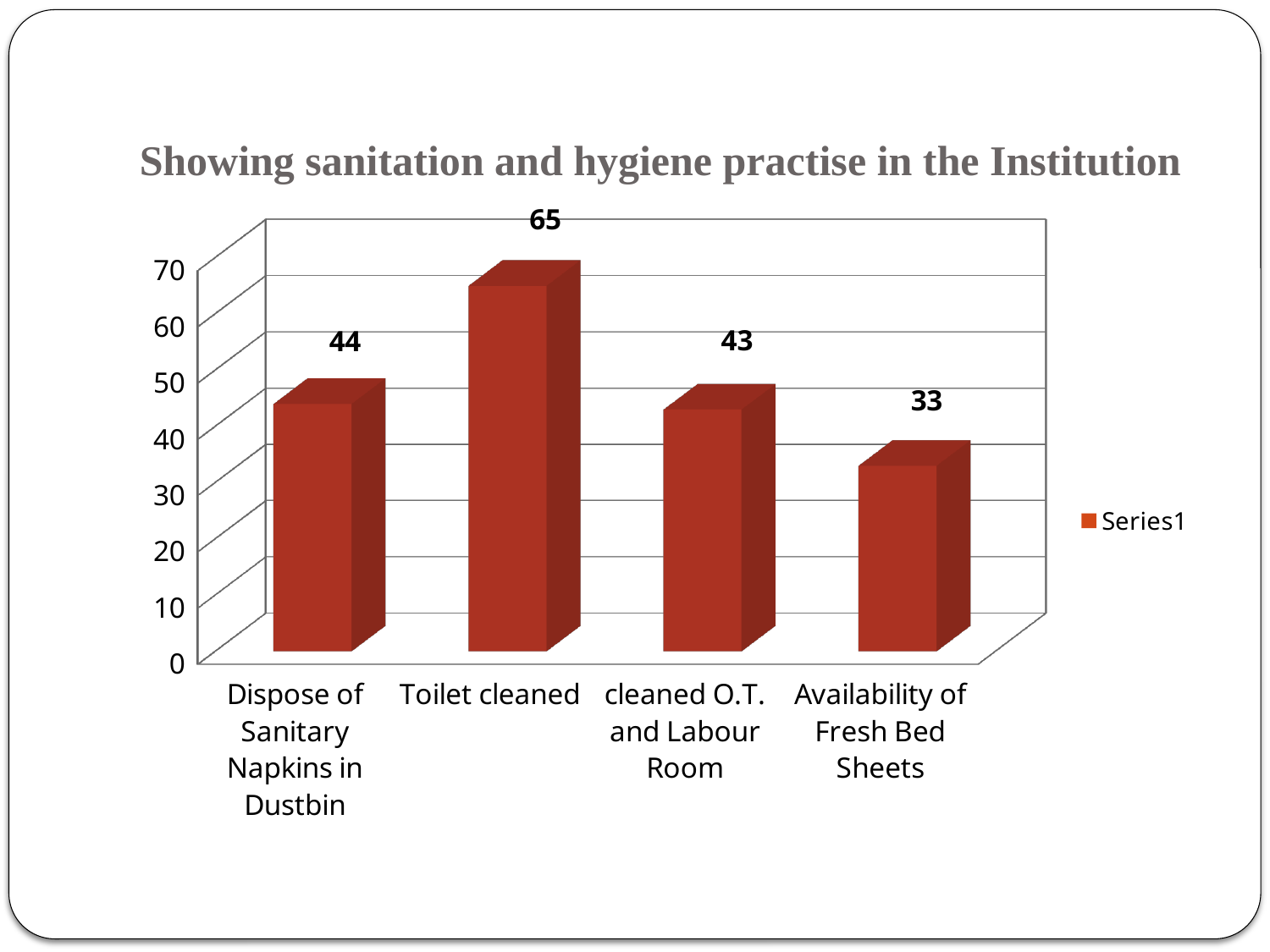
What is the value for Toilet cleaned? 65 What is the value for Dispose of Sanitary Napkins in Dustbin? 44 Which category has the highest value? Toilet cleaned Is the value for Availability of Fresh Bed Sheets greater or less than 40? less How many categories are shown on the x axis? 4 What is the value for Availability of Fresh Bed Sheets? 33 What kind of chart is shown on the slide? bar chart Which is larger, the value for Toilet cleaned or the value for Dispose of Sanitary Napkins in Dustbin? Toilet cleaned What is the difference between the values for Toilet cleaned and Availability of Fresh Bed Sheets? 32 What is the difference between the values for Dispose of Sanitary Napkins in Dustbin and cleaned O.T. and Labour Room? 1 What is the value for cleaned O.T. and Labour Room? 43 Which category has the lowest value? Availability of Fresh Bed Sheets